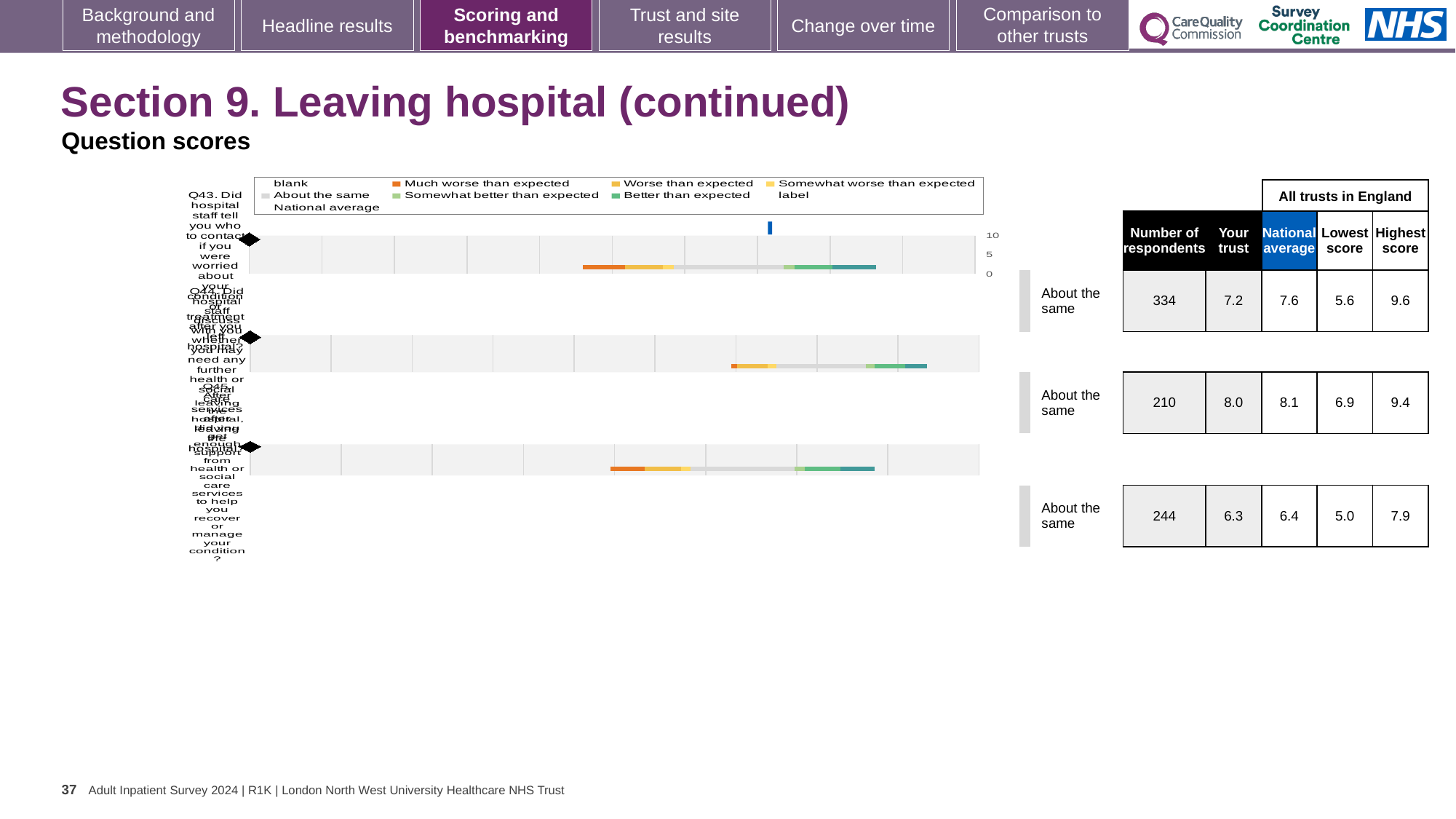
Which question has the highest 'Your trust' score? Q44 How many questions (bars) are plotted in the chart? 3 Which question has the lowest 'Your trust' score? Q45 What is the lowest score among all trusts in England for Q45? 5.0 What is the national average score for Q44? 8.1 What kind of chart is shown on the slide? bar chart What is the number of respondents for Q45 (enough support from health or social care services after leaving hospital)? 244 What is the 'Your trust' score for Q43 (who to contact if worried after leaving hospital)? 7.2 Which is larger, the 'Your trust' score for Q44 or for Q45? Q44 What is the highest score among all trusts in England for Q43? 9.6 What is the difference between the highest and lowest scores for Q43? 4.0 What benchmark category is shown for all three questions on the slide? About the same